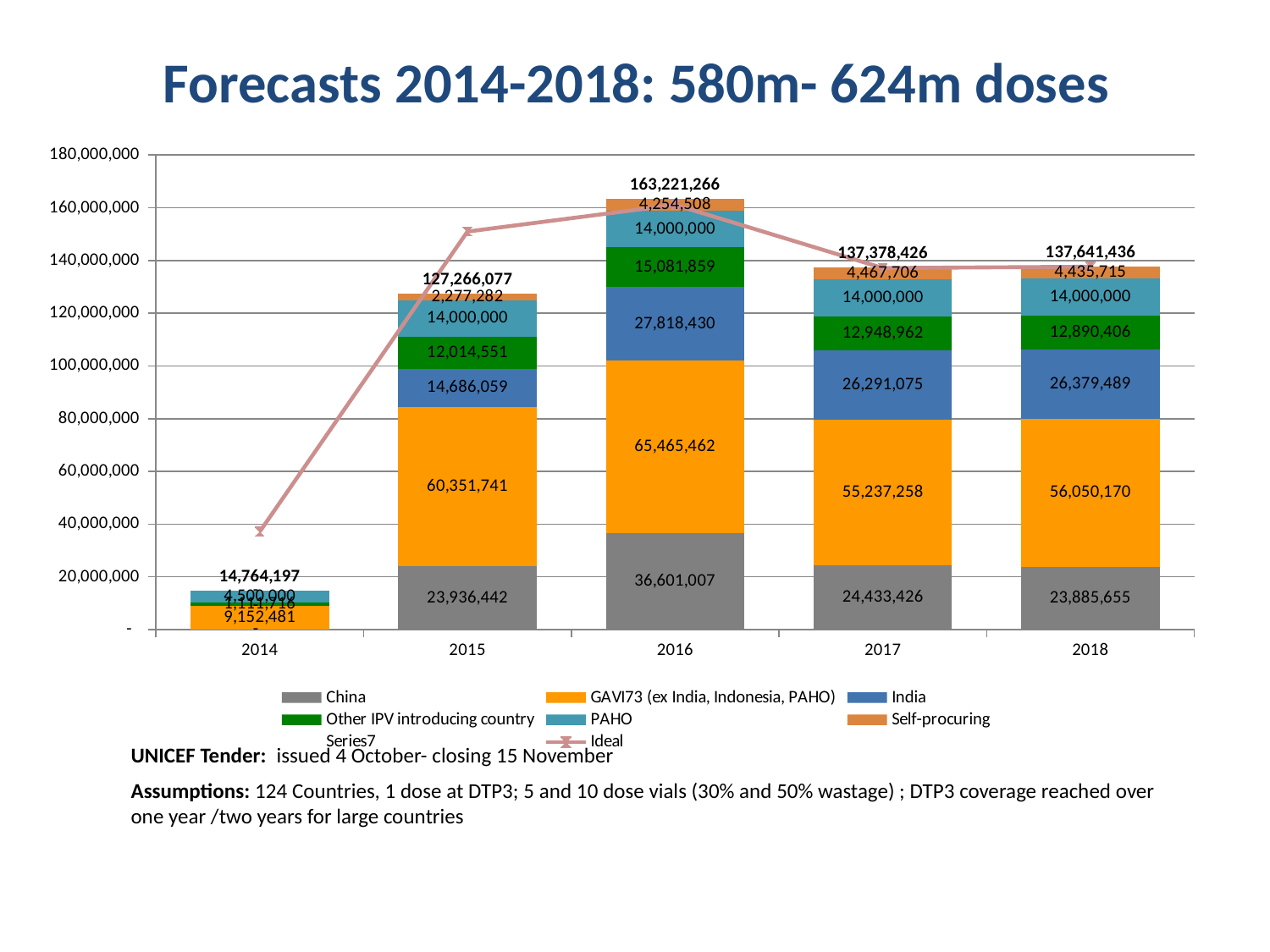
Which year has the lowest total forecast? 2014 By how much does the GAVI73 (ex India, Indonesia, PAHO) value in 2016 exceed the value in 2015? 5,113,721 What is the value for GAVI73 (ex India, Indonesia, PAHO) in 2015? 60,351,741 Which year has the larger India value, 2017 or 2018? 2018 What is the value for India in 2017? 26,291,075 Which year has the highest total forecast? 2016 How many entries does the legend list? 8 Is the Ideal line value for 2015 greater or less than 140,000,000? greater What kind of chart is shown on the slide? A stacked bar chart with a line What is the value for China in 2016? 36,601,007 What is the value for PAHO in 2018? 14,000,000 What is the total number of doses forecast for 2016? 163,221,266